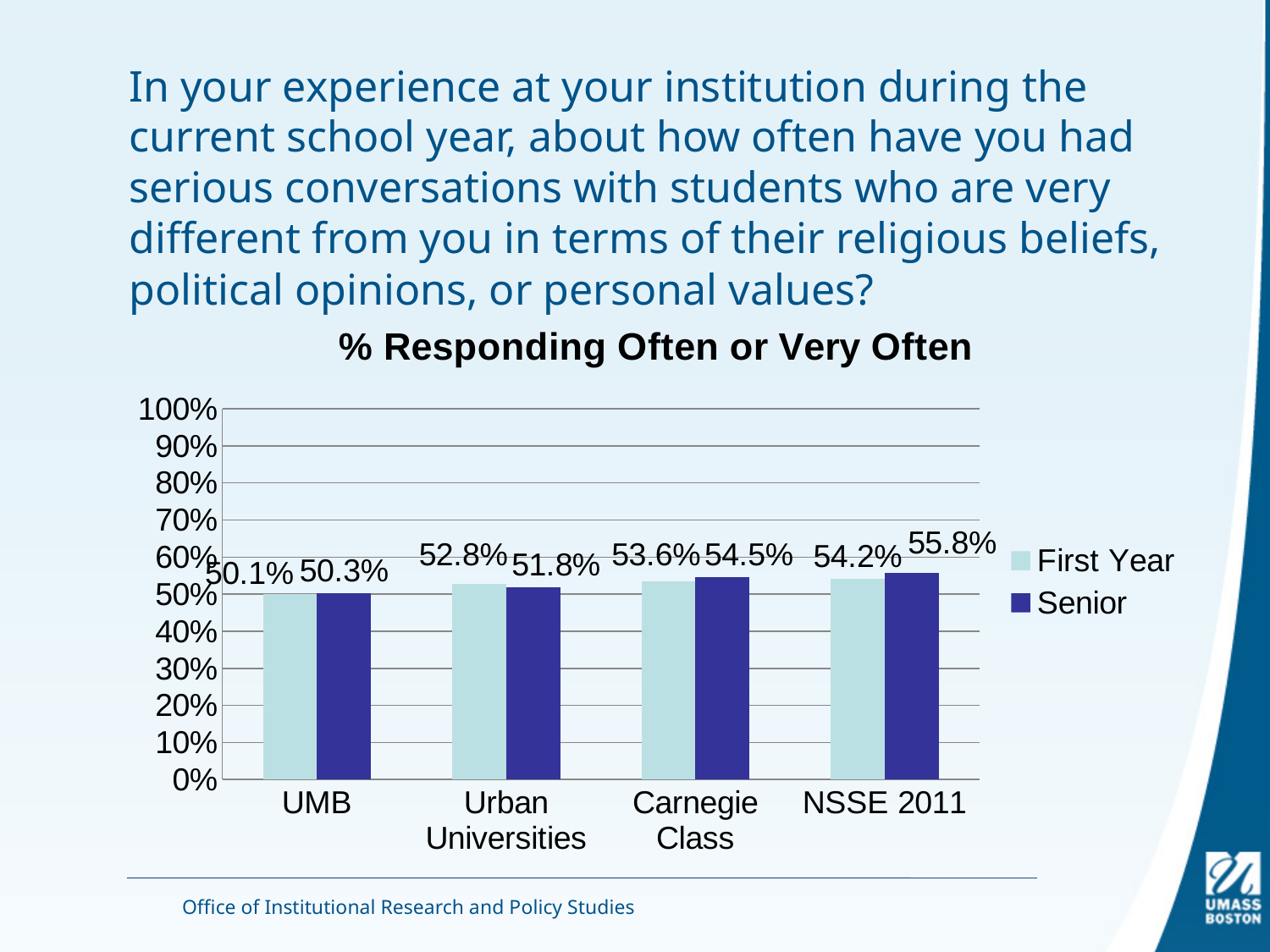
What is the First Year value for UMB? 50.1% What is the title of the chart? % Responding Often or Very Often What is the Senior value for NSSE 2011? 55.8% What is the First Year value for Carnegie Class? 53.6% Which category has the highest Senior value? NSSE 2011 How many categories are shown on the x axis? 4 Which is larger for Urban Universities, the First Year value or the Senior value? First Year Which category has the lowest First Year value? UMB What is the Senior value for Urban Universities? 51.8% What is the difference between the Senior and First Year values for NSSE 2011? 1.6% How many series does the legend list? 2 What kind of chart is shown on the slide? Bar chart